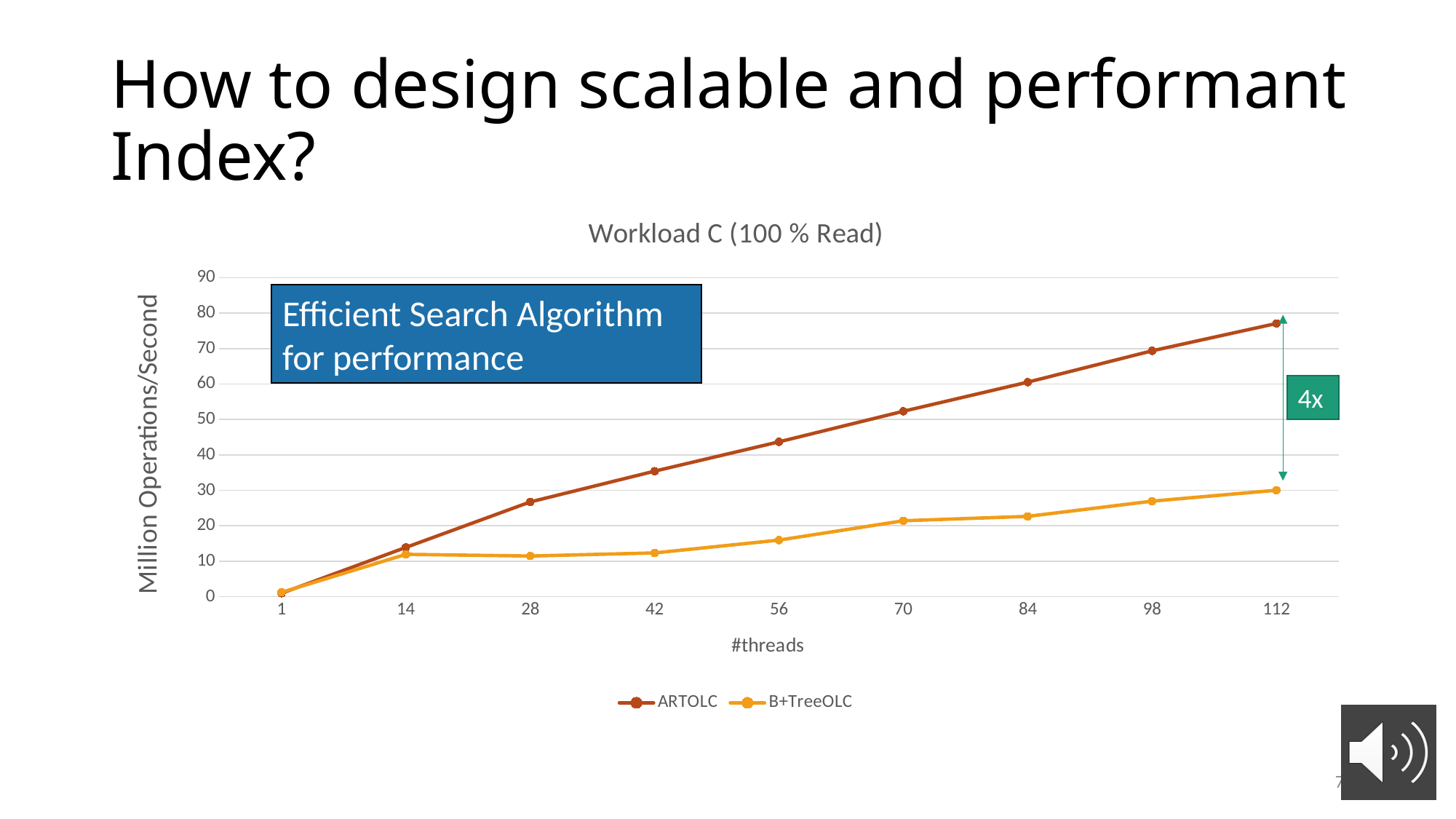
Does the ARTOLC series rise or fall as the number of threads increases? rise At 84 threads, which series has the higher value, ARTOLC or B+TreeOLC? ARTOLC Is the value for B+TreeOLC at 42 threads greater or less than 20? less At which thread count does ARTOLC reach its highest value? 112 What is the title of the chart? Workload C (100 % Read) What kind of chart is shown on the slide? line chart How many series does the legend list? 2 How many thread counts are plotted along the x axis? 9 Is the value for B+TreeOLC at 98 threads greater or less than 30? less What is the label of the y axis? Million Operations/Second Is the value for ARTOLC at 56 threads greater or less than 40? greater